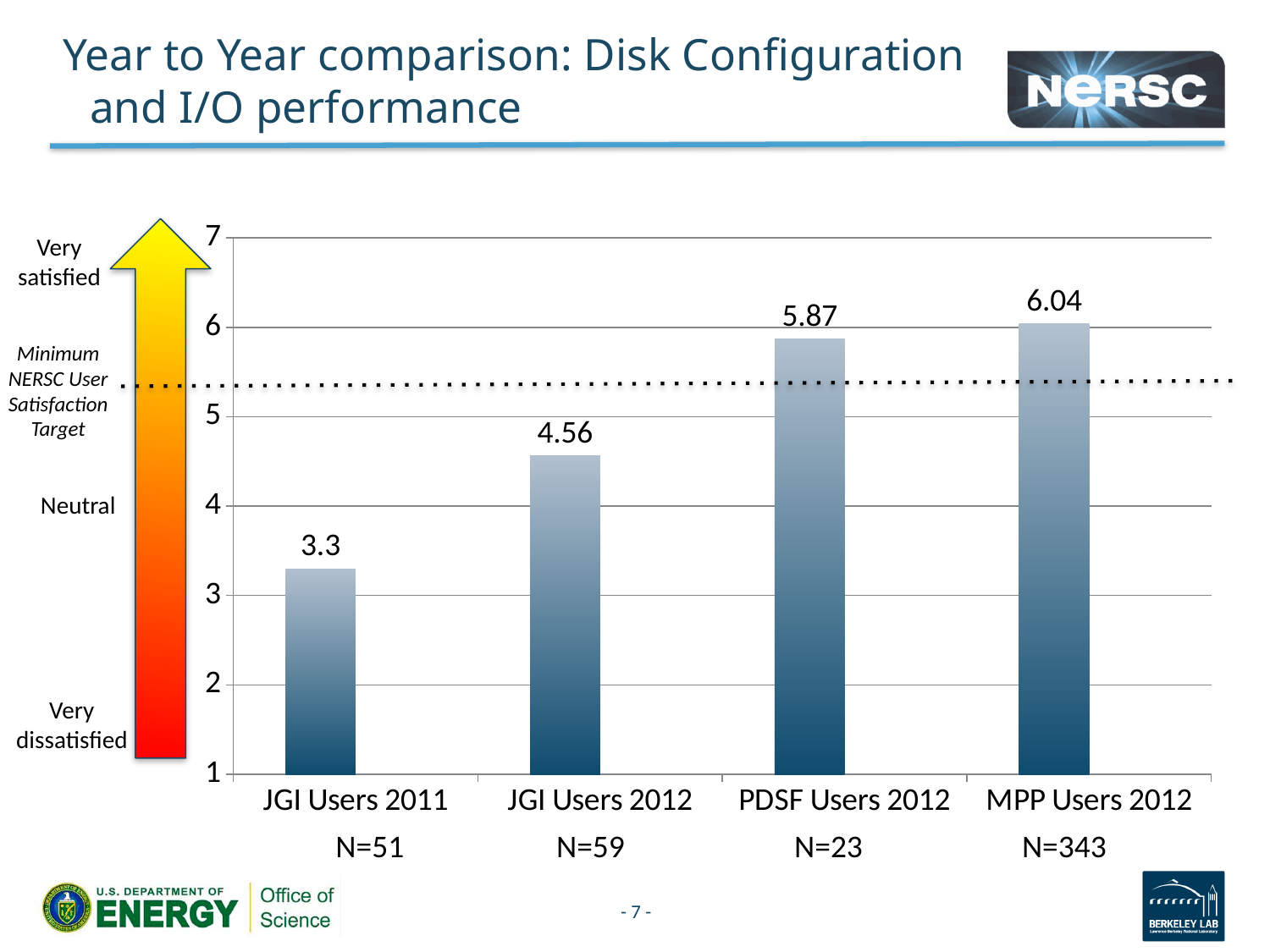
Which is larger, the value for PDSF Users 2012 or the value for JGI Users 2012? PDSF Users 2012 What is the value for JGI Users 2012? 4.56 What is the difference between the values for JGI Users 2012 and JGI Users 2011? 1.26 What kind of chart is shown on the slide? bar chart Which category has the highest value? MPP Users 2012 What is the value for JGI Users 2011? 3.3 How many categories are shown on the x axis? 4 Which category has the lowest value? JGI Users 2011 What is the value for PDSF Users 2012? 5.87 Is the value for JGI Users 2011 greater or less than 4? less What does the dotted horizontal line across the chart represent? Minimum NERSC User Satisfaction Target What is the value for MPP Users 2012? 6.04